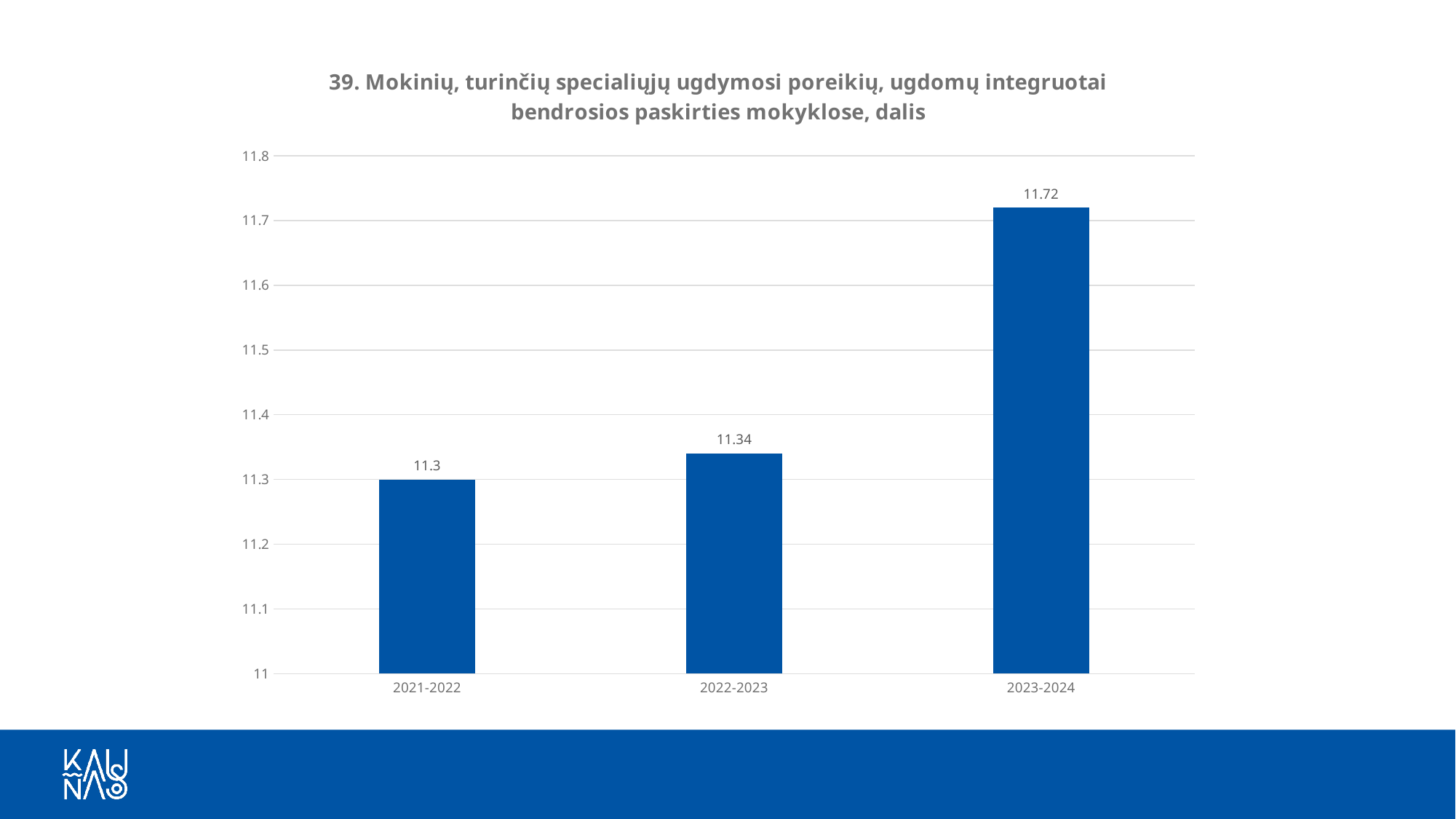
Which period has the highest value? 2023-2024 How many periods are shown on the x axis? 3 What is the difference between the values for 2023-2024 and 2022-2023? 0.38 What is the value for 2021-2022? 11.3 What is the difference between the values for 2022-2023 and 2021-2022? 0.04 Which is larger, the value for 2023-2024 or the value for 2021-2022? 2023-2024 Which period has the lowest value? 2021-2022 Is the value for 2023-2024 greater or less than 11.5? greater What kind of chart is shown on the slide? bar chart What is the value for 2022-2023? 11.34 What is the value for 2023-2024? 11.72 Do the values rise or fall from 2021-2022 to 2023-2024? rise